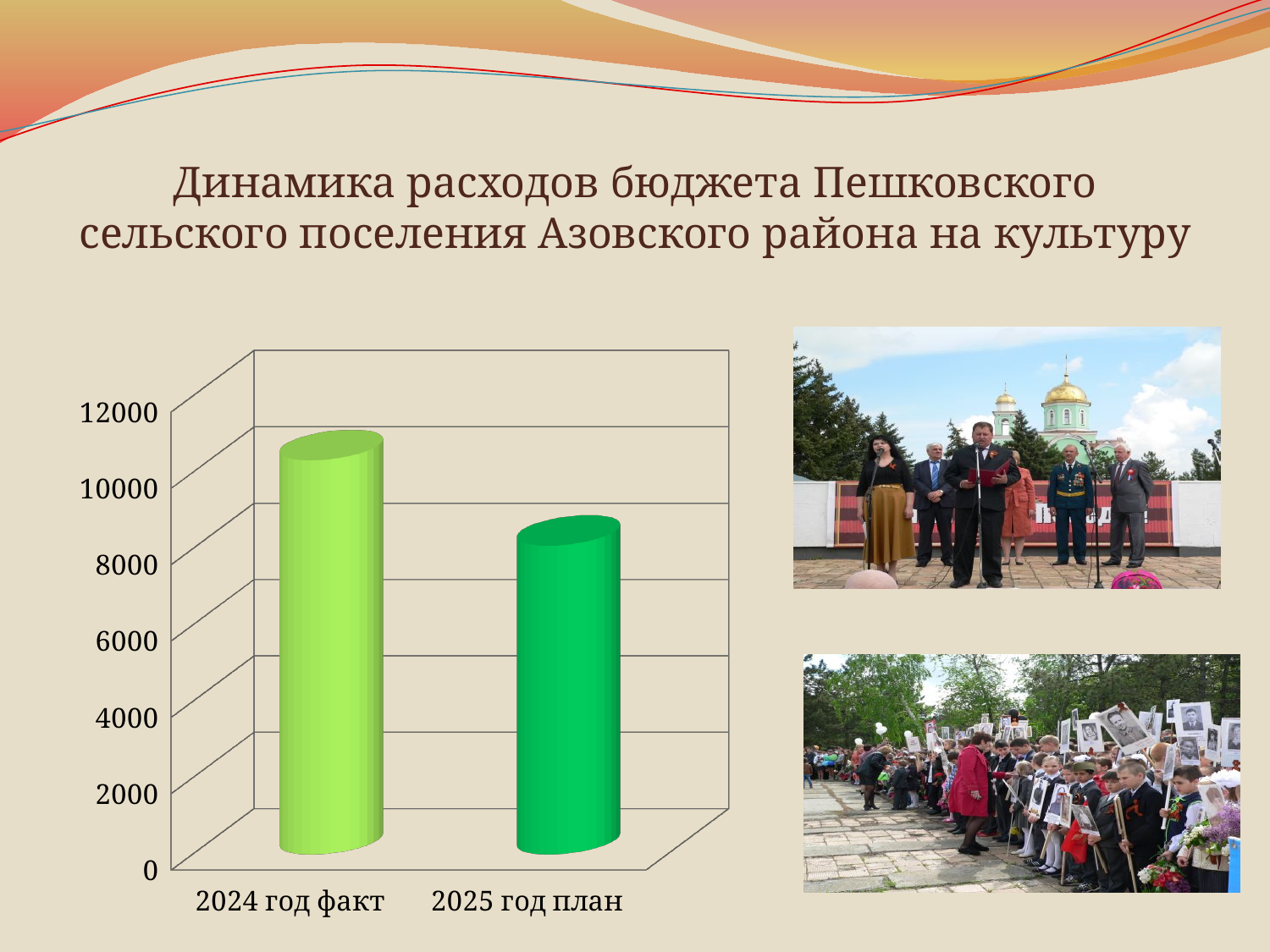
Which is larger, the value for 2024 год факт or the value for 2025 год план? 2024 год факт Do the values rise or fall from 2024 год факт to 2025 год план? fall Is the value for 2024 год факт greater or less than 10000? greater What kind of chart is shown on the slide? bar chart Which category has the lowest value on the chart? 2025 год план Which category has the highest value on the chart? 2024 год факт What is the highest tick value shown on the vertical axis of the chart? 12000 Is the value for 2024 год факт greater or less than 12000? less Is the value for 2025 год план greater or less than 10000? less What is the title of the slide containing the chart? Динамика расходов бюджета Пешковского сельского поселения Азовского района на культуру How many categories are plotted on the chart? 2